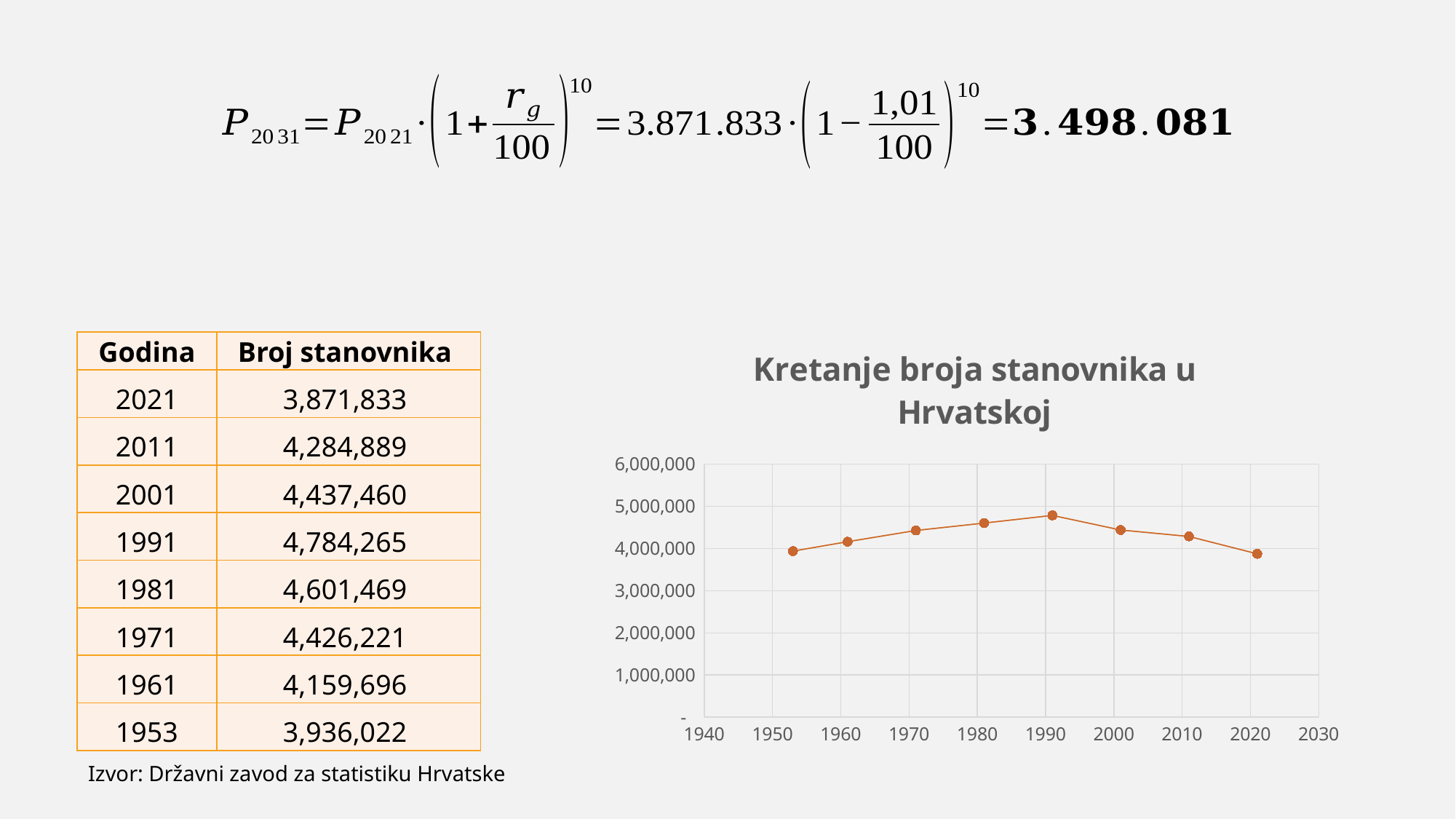
In which year does the chart show the lowest population value? 2021 Do the plotted values rise or fall from 1991 to 2021? fall What kind of chart is shown on the slide? line chart In which year does the chart reach its highest population value? 1991 What is the title of the chart? Kretanje broja stanovnika u Hrvatskoj Do the plotted values rise or fall from 1953 to 1991? rise Is the value plotted for 1971 greater or less than 5,000,000? less Is the value plotted for 1991 greater or less than 4,000,000? greater How many data points are plotted on the chart? 8 What is the highest tick value shown on the chart's vertical axis? 6,000,000 Which year has the larger plotted value, 1981 or 2001? 1981 Is the value plotted for 2021 greater or less than 4,000,000? less